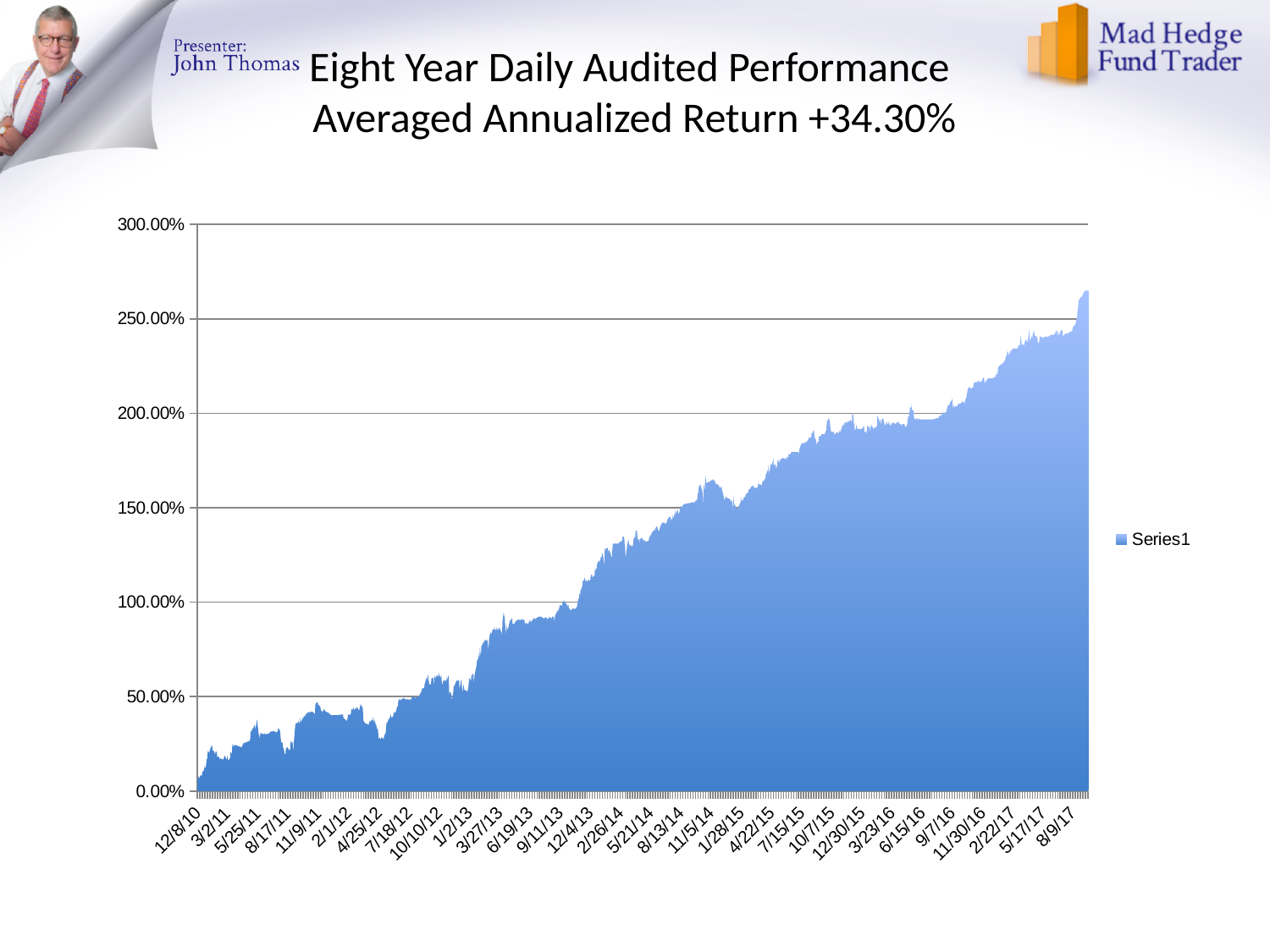
Do the values generally rise or fall from 12/8/10 to 8/9/17? rise Which is larger, the value at 8/9/17 or the value at 12/8/10? 8/9/17 Is the value at 6/19/13 greater or less than 100%? less Is the value at 11/5/14 greater or less than 150%? greater What is the name of the series shown in the legend? Series1 Is the value at 2/22/17 greater or less than 200%? greater What kind of chart is shown on the slide? area chart How many series does the legend list? 1 What is the highest value shown on the vertical axis? 300.00%